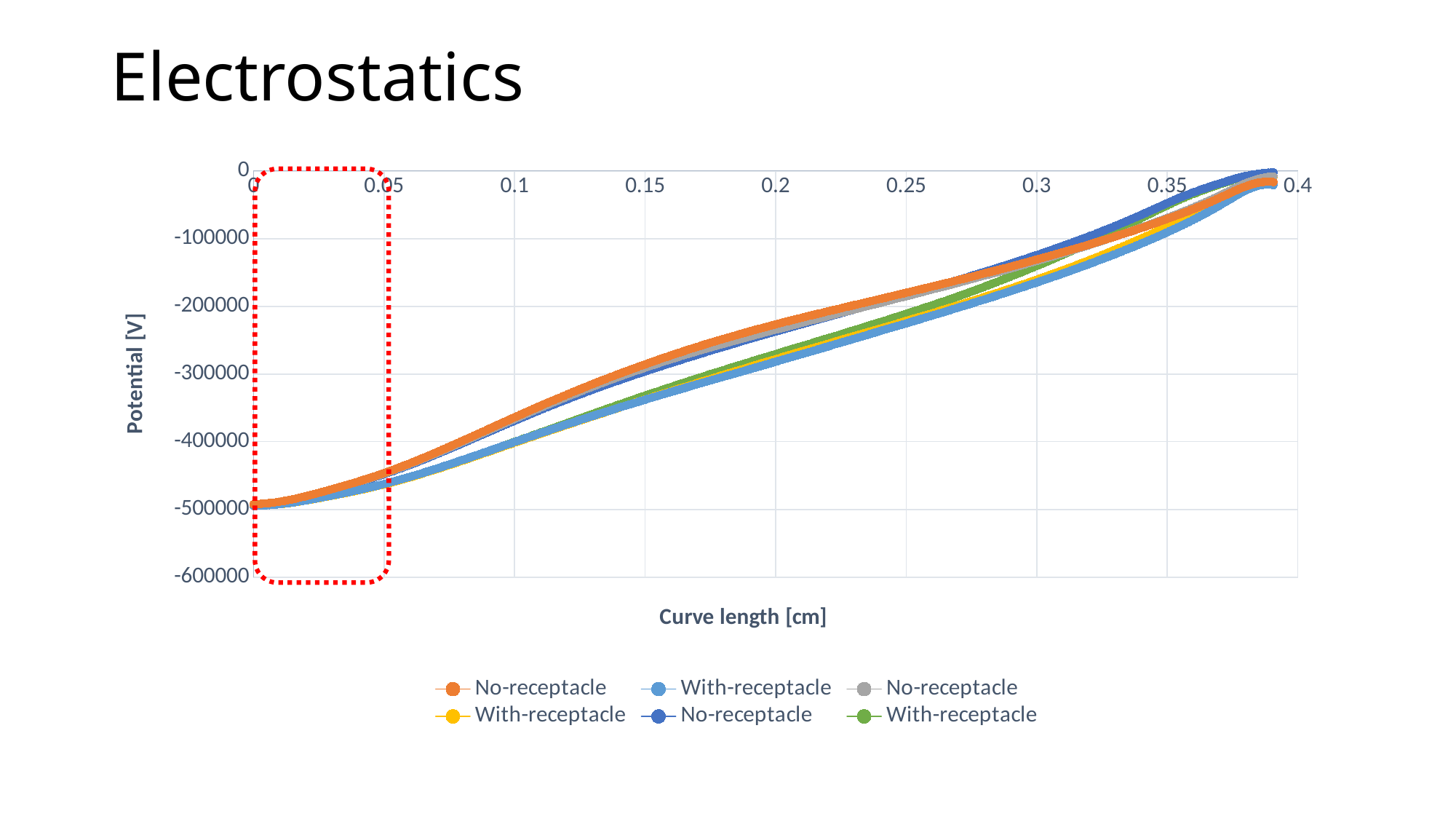
Do the plotted potential values rise or fall as curve length increases from 0 to 0.4? rise Is the value of the light blue With-receptacle series at curve length 0.15 greater or less than -300000? less What is the title of the x axis? Curve length [cm] Is the value of the light blue With-receptacle series at curve length 0.3 greater or less than -100000? less Is the value of the orange No-receptacle series at curve length 0.3 greater or less than -200000? greater How many series does the legend list? 6 How many labelled tick marks are on the x axis? 9 What is the lowest value labelled on the y axis? -600000 What is the title of the y axis? Potential [V] At curve length 0.2, which series has the higher potential: the orange No-receptacle series or the light blue With-receptacle series? orange No-receptacle What kind of chart is shown on the slide? line chart